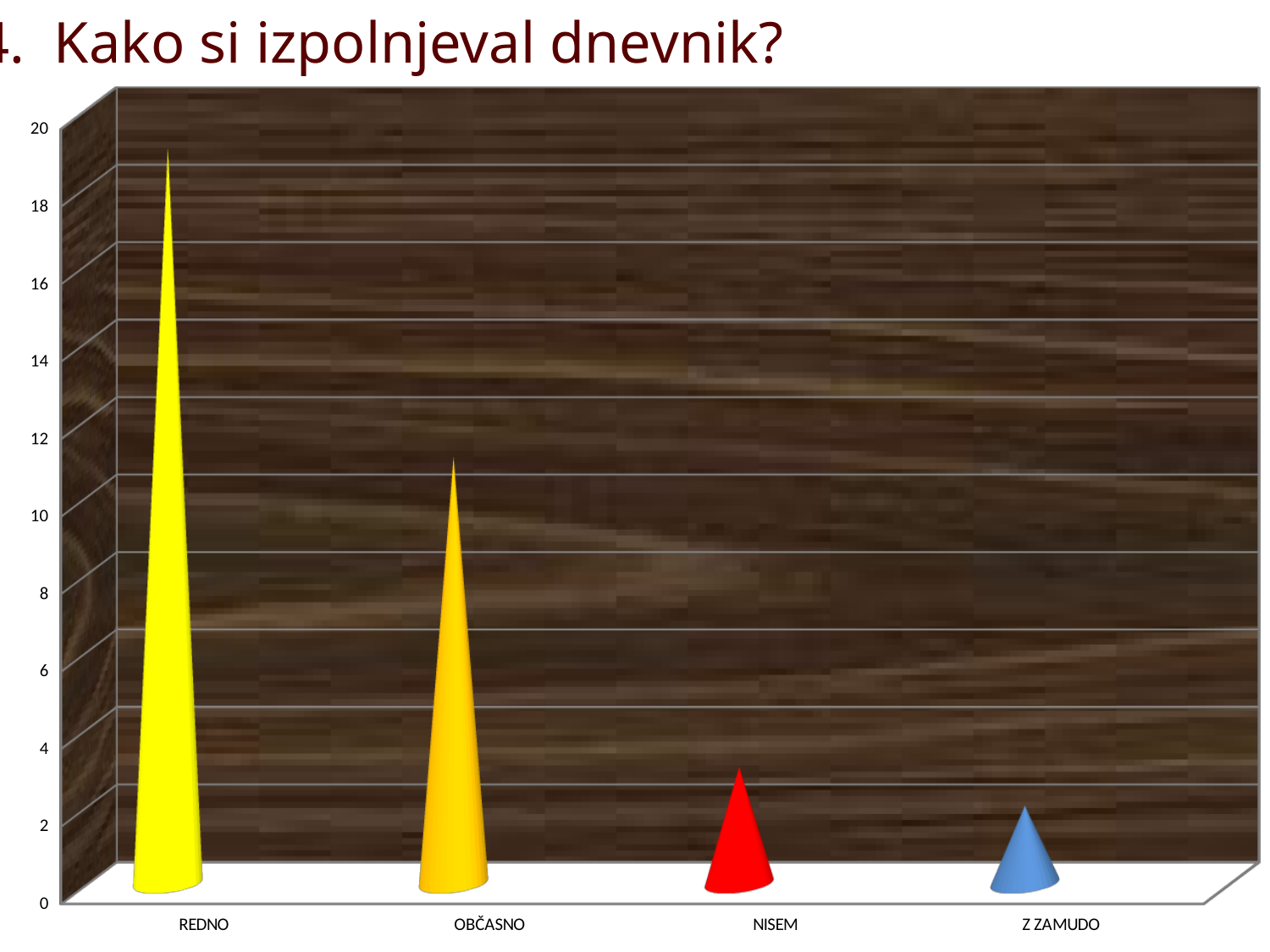
How many categories are shown on the x axis of the chart? 4 What colour is the bar for NISEM? red Which category has the highest value in the chart? REDNO Which has a larger value, REDNO or OBČASNO? REDNO Is the value for REDNO greater or less than 16? greater Is the value for Z ZAMUDO greater or less than 4? less What kind of chart is shown on the slide? bar chart Which has a larger value, OBČASNO or NISEM? OBČASNO Do the values rise or fall from left to right along the x axis? fall Is the value for NISEM greater or less than 6? less Which category has the lowest value in the chart? Z ZAMUDO